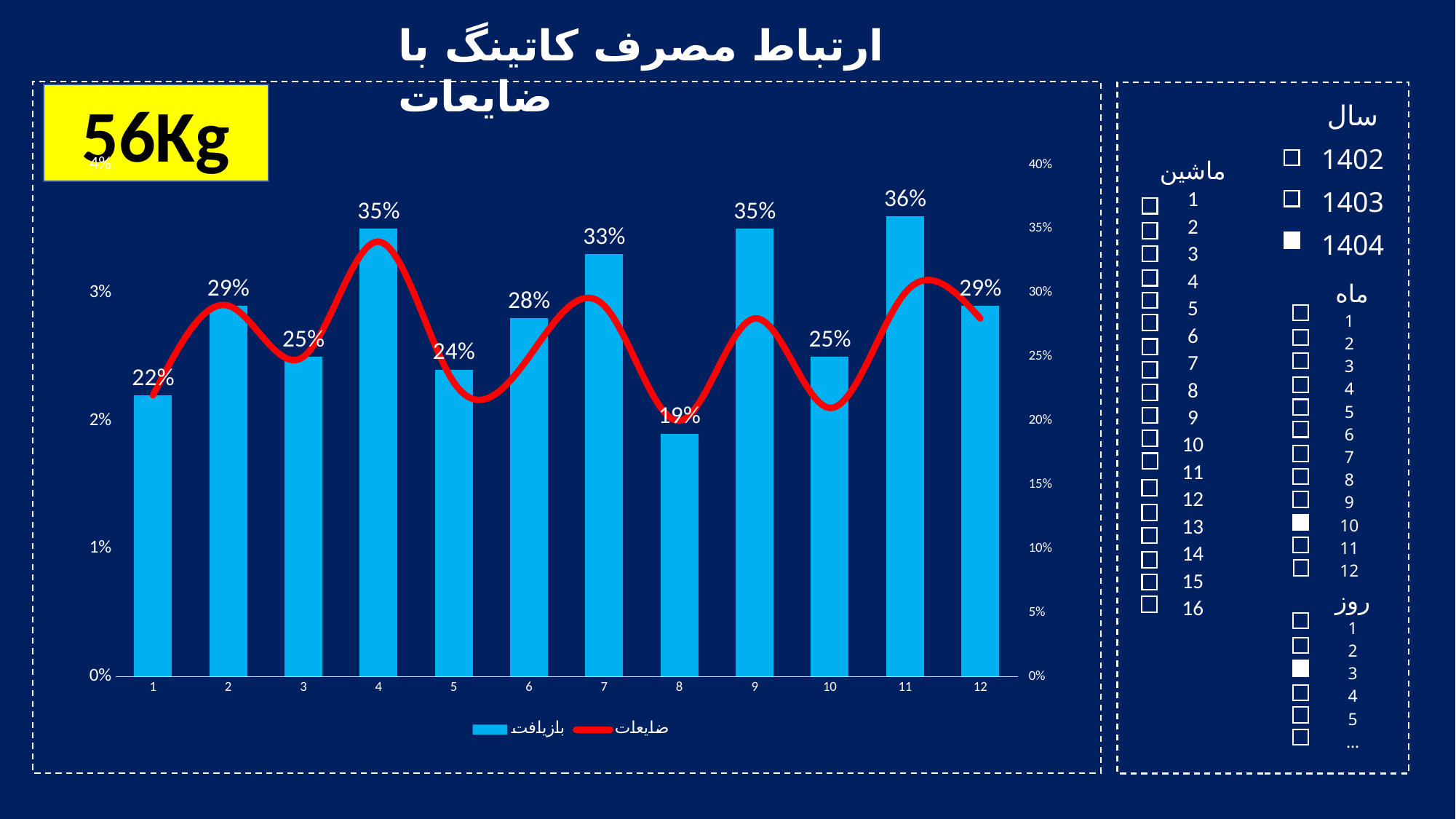
Which category has the lowest bar value? 8 How many categories are shown on the x axis? 12 Which has a larger bar value, category 2 or category 5? Category 2 What is the difference between the bar values for categories 7 and 6? 5% What kind of chart is shown? Combined bar and line chart What is the value of the bar for category 8? 19% What is the value of the bar for category 1? 22% What is the difference between the bar values for categories 11 and 8? 17% Which category has the highest bar value? 11 How many series does the legend list? 2 What is the value of the bar for category 4? 35% Do the bar values rise or fall from category 7 to category 8? Fall